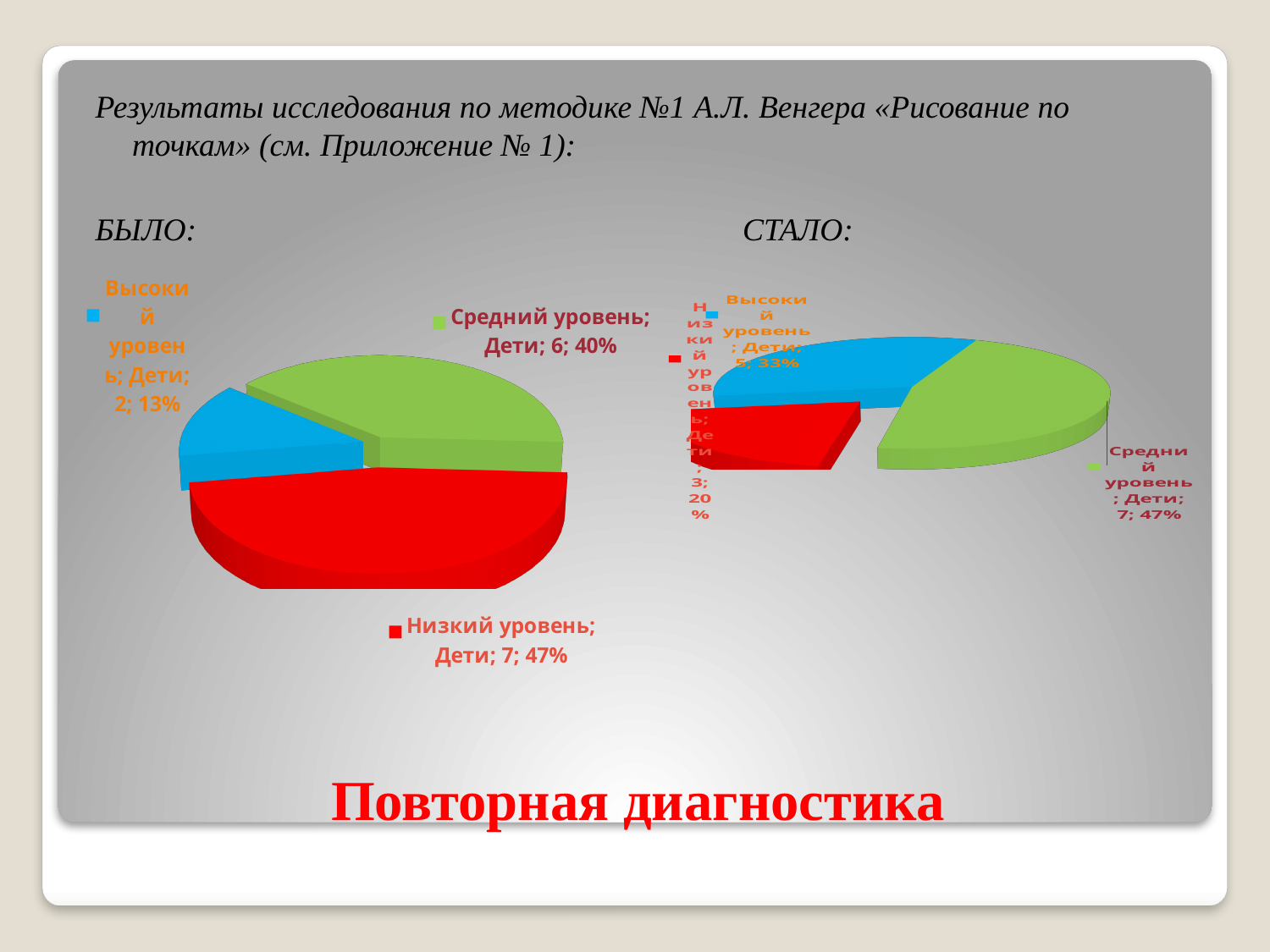
In the "БЫЛО:" chart, how many slices does the pie have? 3 In the "БЫЛО:" chart, which level has the smallest slice? Высокий уровень In the "БЫЛО:" chart, which level has the largest slice? Низкий уровень In the "СТАЛО:" chart, how many children are at the high level (Высокий уровень)? 5 In the "СТАЛО:" chart, what percentage share does the middle level (Средний уровень) have? 47% In the "БЫЛО:" chart, how many children are at the low level (Низкий уровень)? 7 In the "БЫЛО:" chart, what colour is the slice for the middle level (Средний уровень)? green Which chart has more children at the high level (Высокий уровень), "БЫЛО:" or "СТАЛО:"? СТАЛО: In the "СТАЛО:" chart, what is the difference in number of children between the middle level and the low level? 4 What kind of chart is shown under "БЫЛО:"? pie chart In the "СТАЛО:" chart, which level has the smallest slice? Низкий уровень In the "БЫЛО:" chart, what percentage share does the high level (Высокий уровень) have? 13%